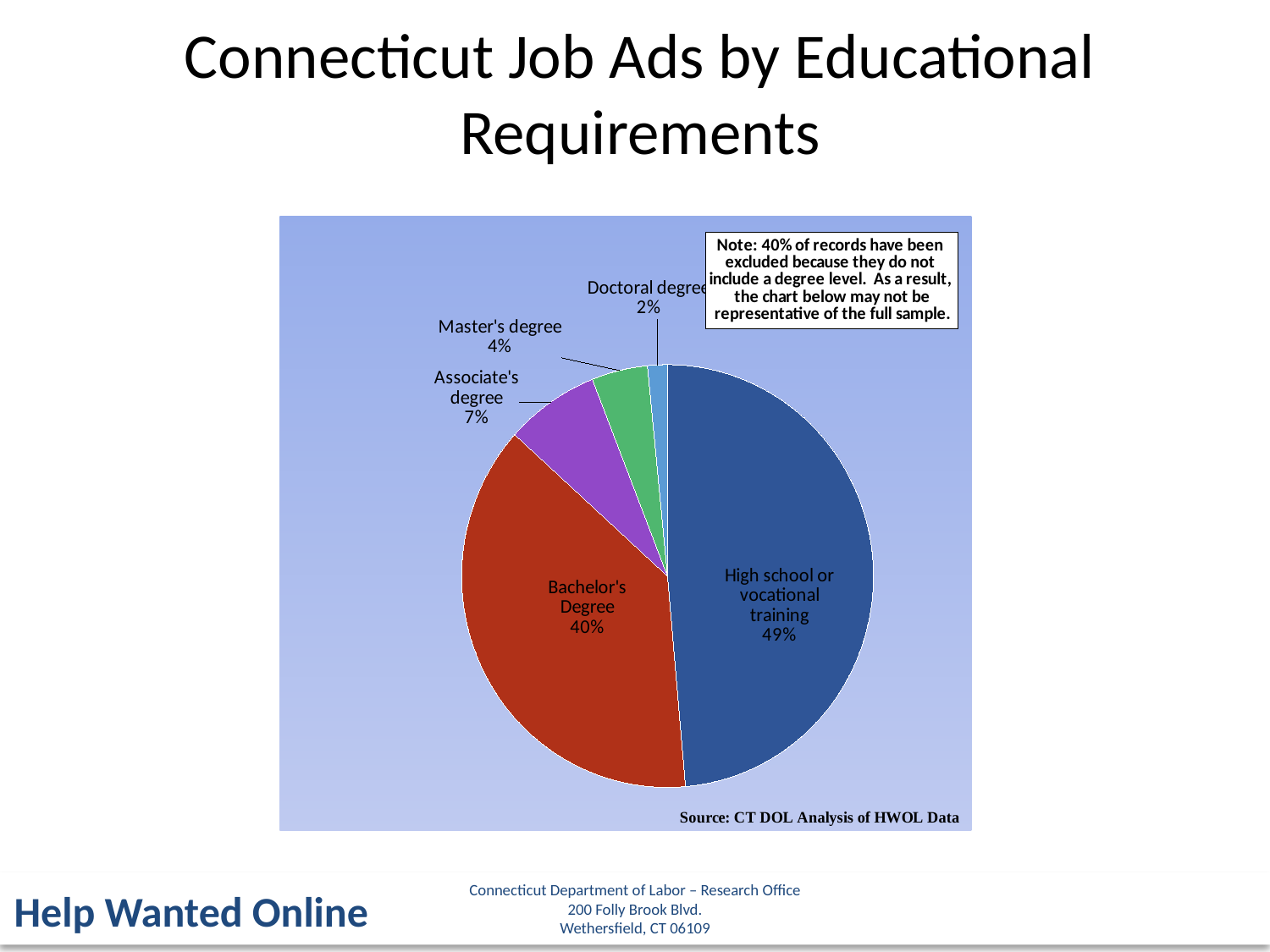
What share of Connecticut job ads require a Bachelor's Degree? 40% What percentage of job ads require an Associate's degree? 7% Which is larger: the share for Associate's degree or the share for Master's degree? Associate's degree What is the difference in percentage points between the high school or vocational training share and the Bachelor's Degree share? 9 Which educational requirement has the largest share of job ads? High school or vocational training What share of job ads require high school or vocational training? 49% What percentage of job ads require a Doctoral degree? 2% Which educational requirement has the smallest share of job ads? Doctoral degree What percentage of job ads require a Master's degree? 4% What kind of chart is shown on the slide? pie chart According to the note on the chart, what percentage of records were excluded because they do not include a degree level? 40% How many educational requirement categories are shown in the pie chart? 5